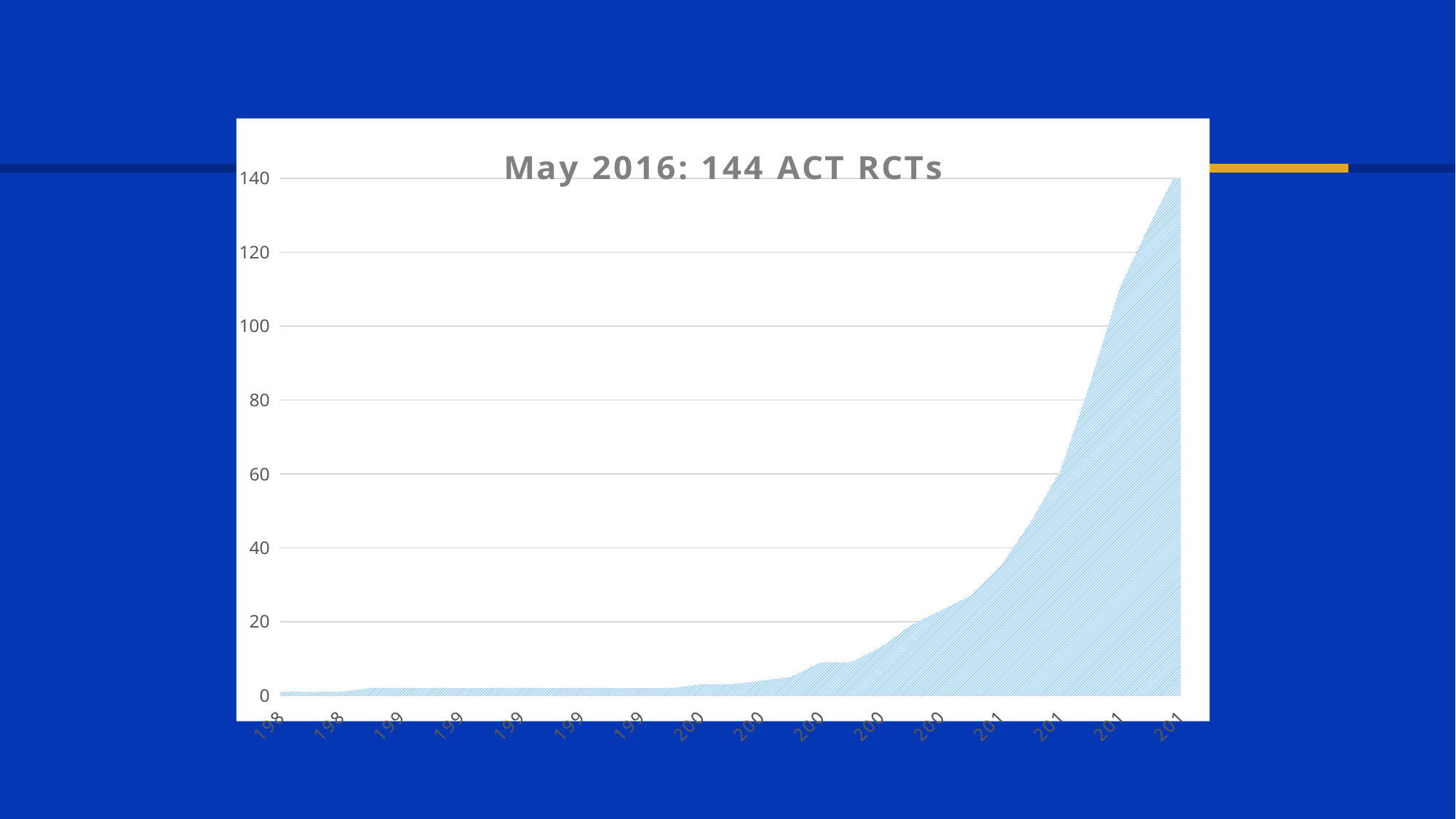
What is the highest value shown on the y axis? 140 Do the values generally rise or fall from left to right along the x axis? rise Is the value at the midpoint of the x axis greater or less than 20? less Is the value at the right-hand end of the chart greater or less than 100? greater How many tick labels are shown along the x axis? 16 Is the value at the right-hand end of the chart greater or less than 120? greater What kind of chart is shown on the slide? area chart What is the title of the chart? May 2016: 144 ACT RCTs Which end of the chart has the higher value, the left end or the right end? right end